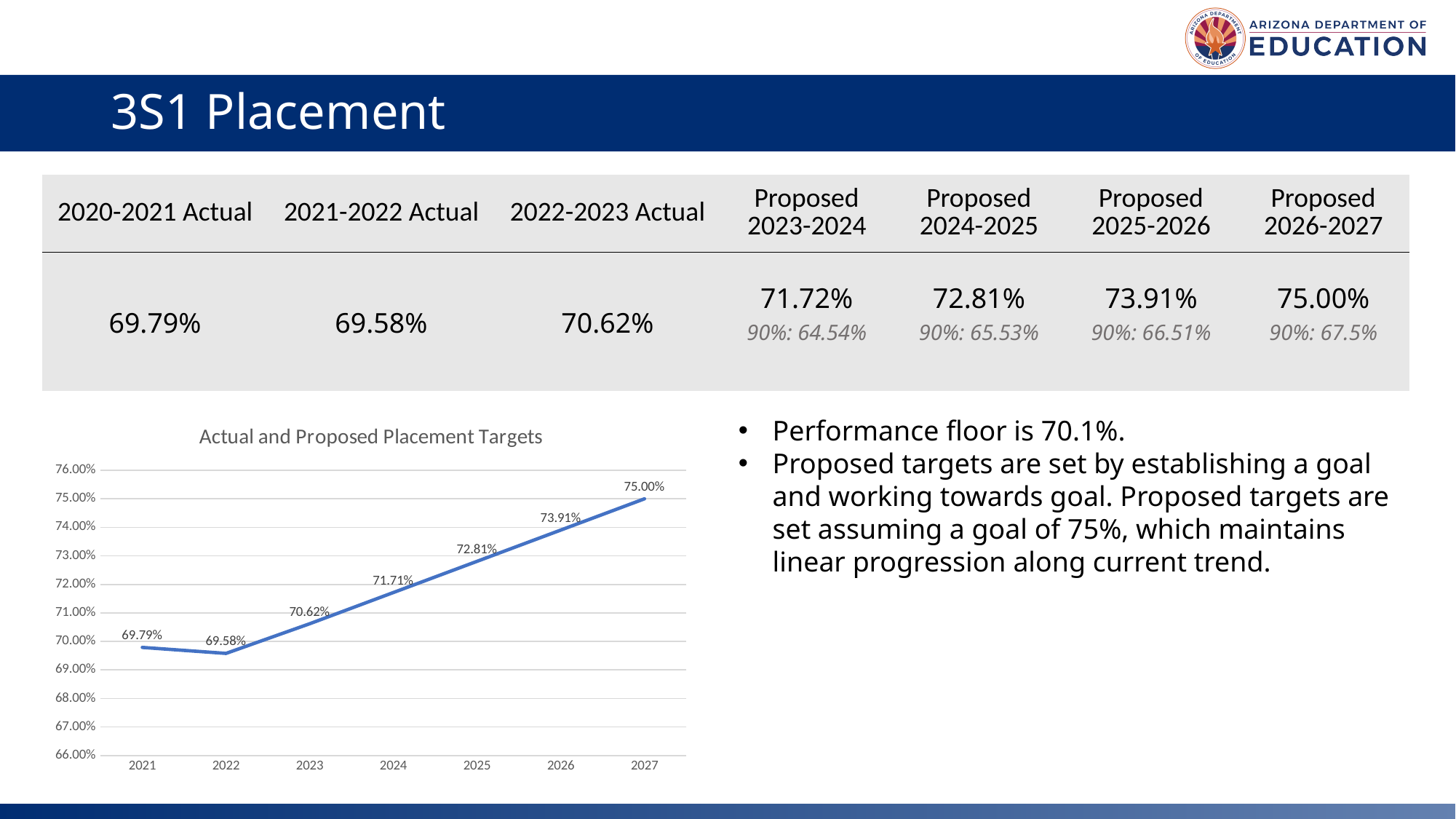
What is the difference between the chart values for 2027 and 2023? 4.38% What is the value plotted for 2023 in the chart? 70.62% Is the value for 2026 in the chart greater or less than 73.00%? greater What type of chart is shown on the slide? Line chart What is the value plotted for 2025 in the chart? 72.81% Do the values in the chart generally rise or fall from 2022 to 2027? Rise How many data points are plotted in the chart? 7 What is the value plotted for 2021 in the chart? 69.79% What is the title of the chart? Actual and Proposed Placement Targets Which year has the lowest value in the chart? 2022 Which year has the highest value in the chart? 2027 Which is larger in the chart, the value for 2022 or the value for 2024? 2024